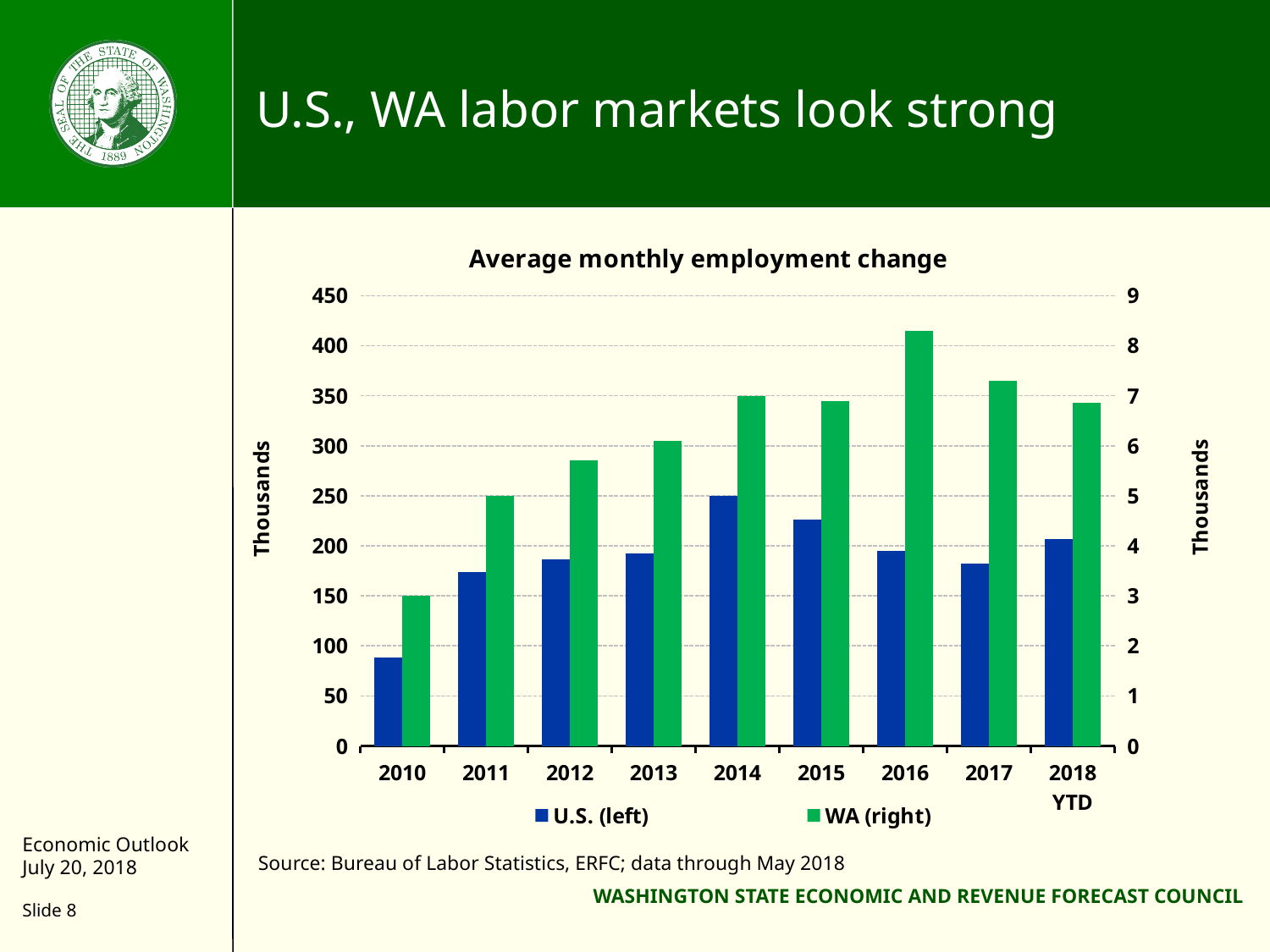
What is the title of the chart? Average monthly employment change Is the U.S. value for 2010 greater or less than 100 on the left axis? less How many years (categories) are shown along the x axis? 9 In which year is the WA average monthly employment change lowest? 2010 Did the U.S. average monthly employment change rise or fall from 2010 to 2014? rise In which year is the U.S. average monthly employment change highest? 2014 In which year is the U.S. average monthly employment change lowest? 2010 Is the WA value for 2016 greater or less than 8 on the right axis? greater How many series does the legend list? 2 Which is larger, the U.S. value for 2014 or the U.S. value for 2015? 2014 What type of chart is shown on the slide? Bar chart In which year is the WA average monthly employment change highest? 2016